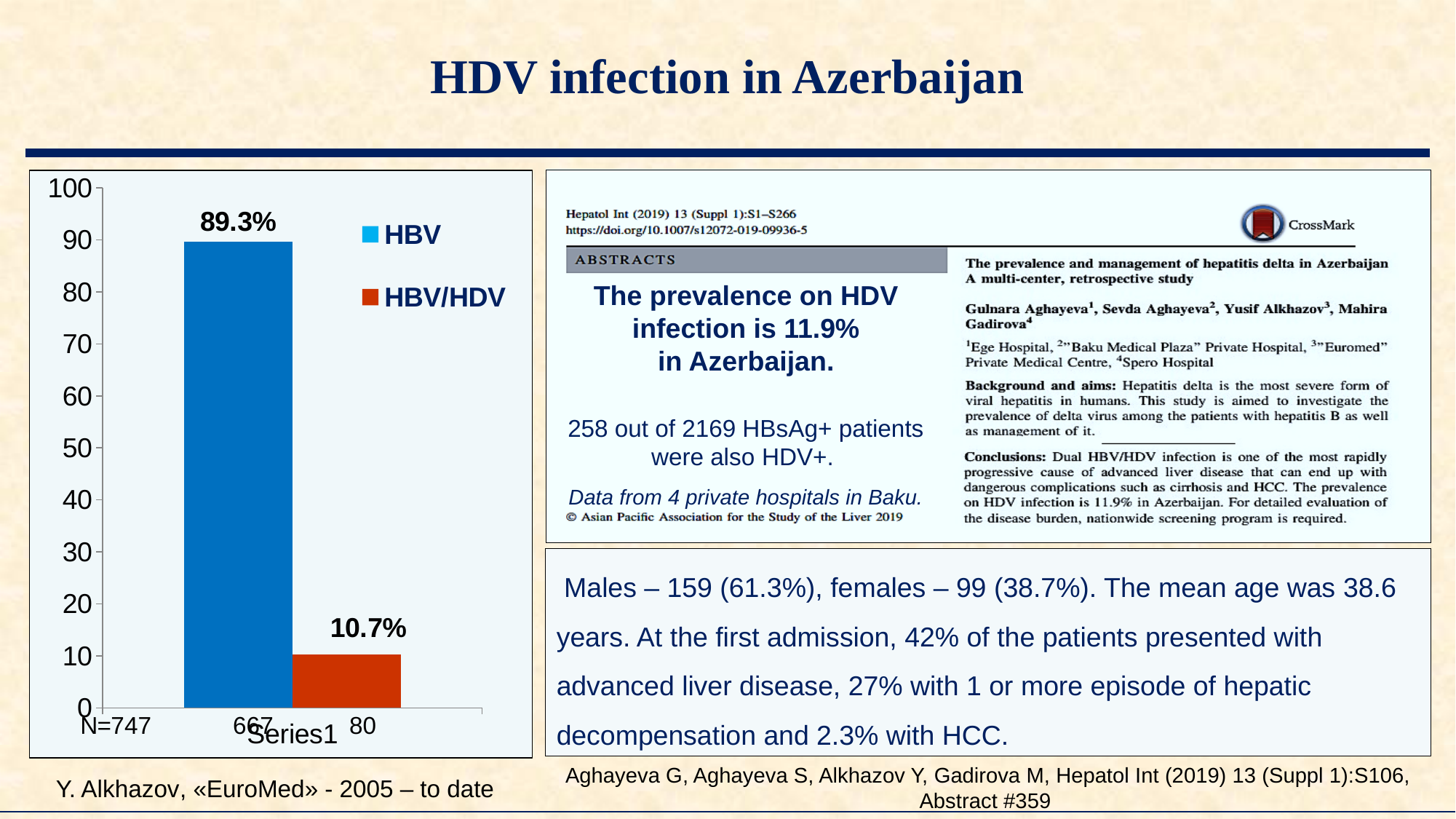
What is the maximum value shown on the chart's vertical axis? 100 Is the value for HBV/HDV greater or less than 20? less Which series has the lowest value in the chart? HBV/HDV Which series has the highest value in the chart? HBV Which series has the taller bar in the chart, HBV or HBV/HDV? HBV What kind of chart is shown on the slide? bar chart How many series does the chart legend list? 2 What value is shown for the HBV bar in the chart? 89.3% What colour is the HBV/HDV bar in the chart? red What is the difference between the HBV value and the HBV/HDV value in the chart? 78.6% What value is shown for the HBV/HDV bar in the chart? 10.7% Is the value for HBV greater or less than 80? greater